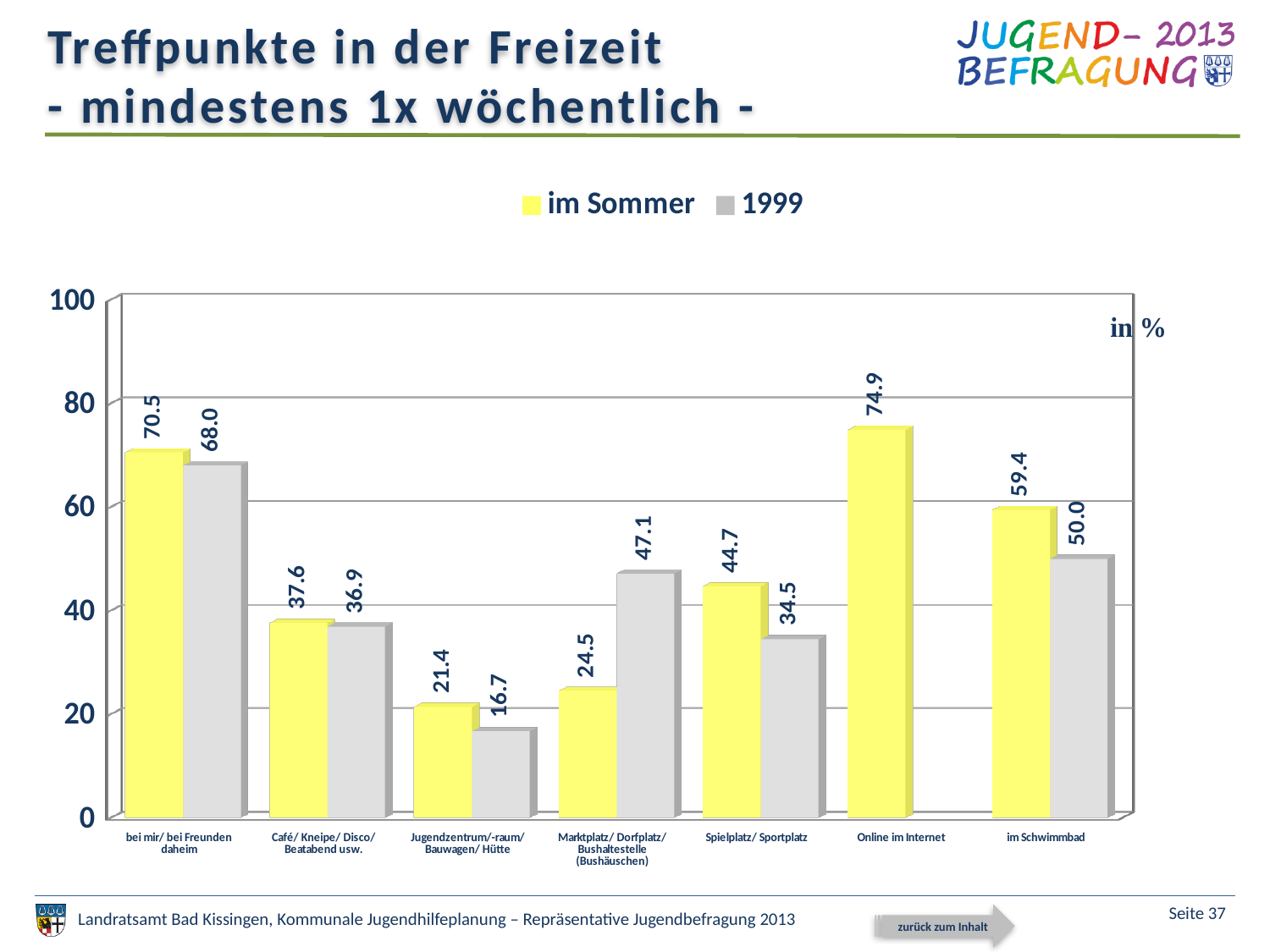
What is the "im Sommer" value for "im Schwimmbad"? 59.4 Which category has the lowest 1999 value? Jugendzentrum/-raum/ Bauwagen/ Hütte How many categories are shown on the x axis? 7 What is the 1999 value for "Marktplatz/ Dorfplatz/ Bushaltestelle (Bushäuschen)"? 47.1 What is the value for "Online im Internet" in the "im Sommer" series? 74.9 How many series does the legend list? 2 Which category has the highest "im Sommer" value? Online im Internet What kind of chart is shown on the slide? bar chart Is the "im Sommer" value for "bei mir/ bei Freunden daheim" greater or less than 60? greater What is the difference between the "im Sommer" and 1999 values for "Spielplatz/ Sportplatz"? 10.2 Which category has no 1999 bar? Online im Internet For "Marktplatz/ Dorfplatz/ Bushaltestelle (Bushäuschen)", which series has the larger value, "im Sommer" or 1999? 1999